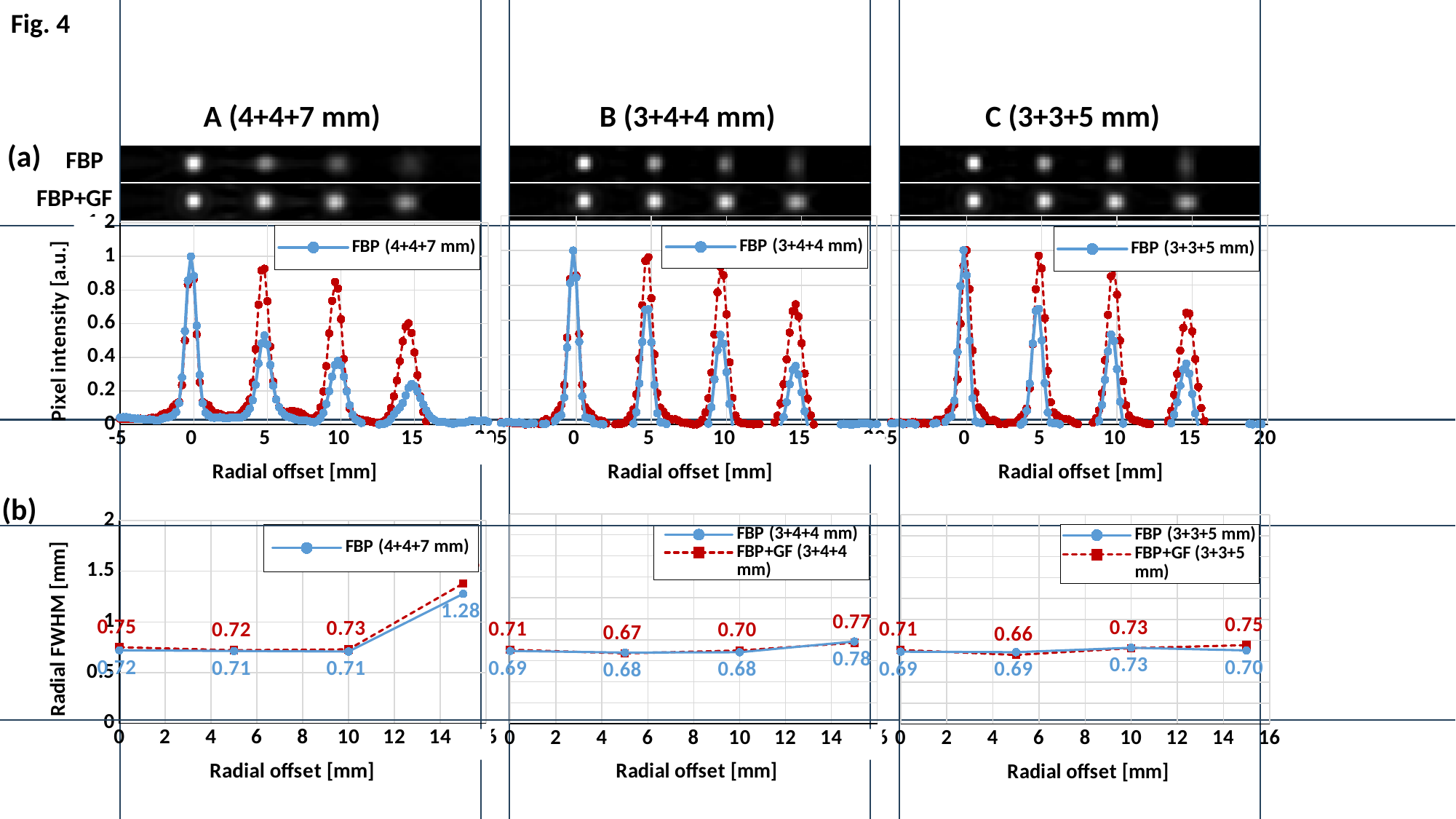
In the bottom-right Radial FWHM chart (3+3+5 mm), which is larger at a radial offset of 15 mm: the FBP+GF value or the FBP value? FBP+GF In the bottom-middle Radial FWHM chart (3+4+4 mm), what is the difference between the FBP value at 15 mm and the FBP value at 0 mm? 0.09 In the top-left Pixel intensity chart (4+4+7 mm), is the FBP peak at a radial offset of 15 mm greater or less than 0.4? less In the bottom-middle Radial FWHM chart (3+4+4 mm), what is the FBP+GF value at a radial offset of 5 mm? 0.67 How many series does the legend of the bottom-middle Radial FWHM chart (3+4+4 mm) list? 2 In the bottom-right Radial FWHM chart (3+3+5 mm), at which radial offset is the FBP+GF value lowest? 5 mm In the top-right Pixel intensity chart (3+3+5 mm), is the FBP peak at a radial offset of 5 mm greater or less than 0.6? greater In the bottom-left Radial FWHM chart for FBP (4+4+7 mm), what is the FBP value at a radial offset of 15 mm? 1.28 In the bottom-left Radial FWHM chart (4+4+7 mm), what is the red FBP+GF value at a radial offset of 0 mm? 0.75 What kind of chart is the top-middle Pixel intensity chart (3+4+4 mm)? line chart In the bottom-right Radial FWHM chart (3+3+5 mm), what is the FBP value at a radial offset of 15 mm? 0.70 In the bottom-left Radial FWHM chart (4+4+7 mm), at which radial offset is the FBP value highest? 15 mm